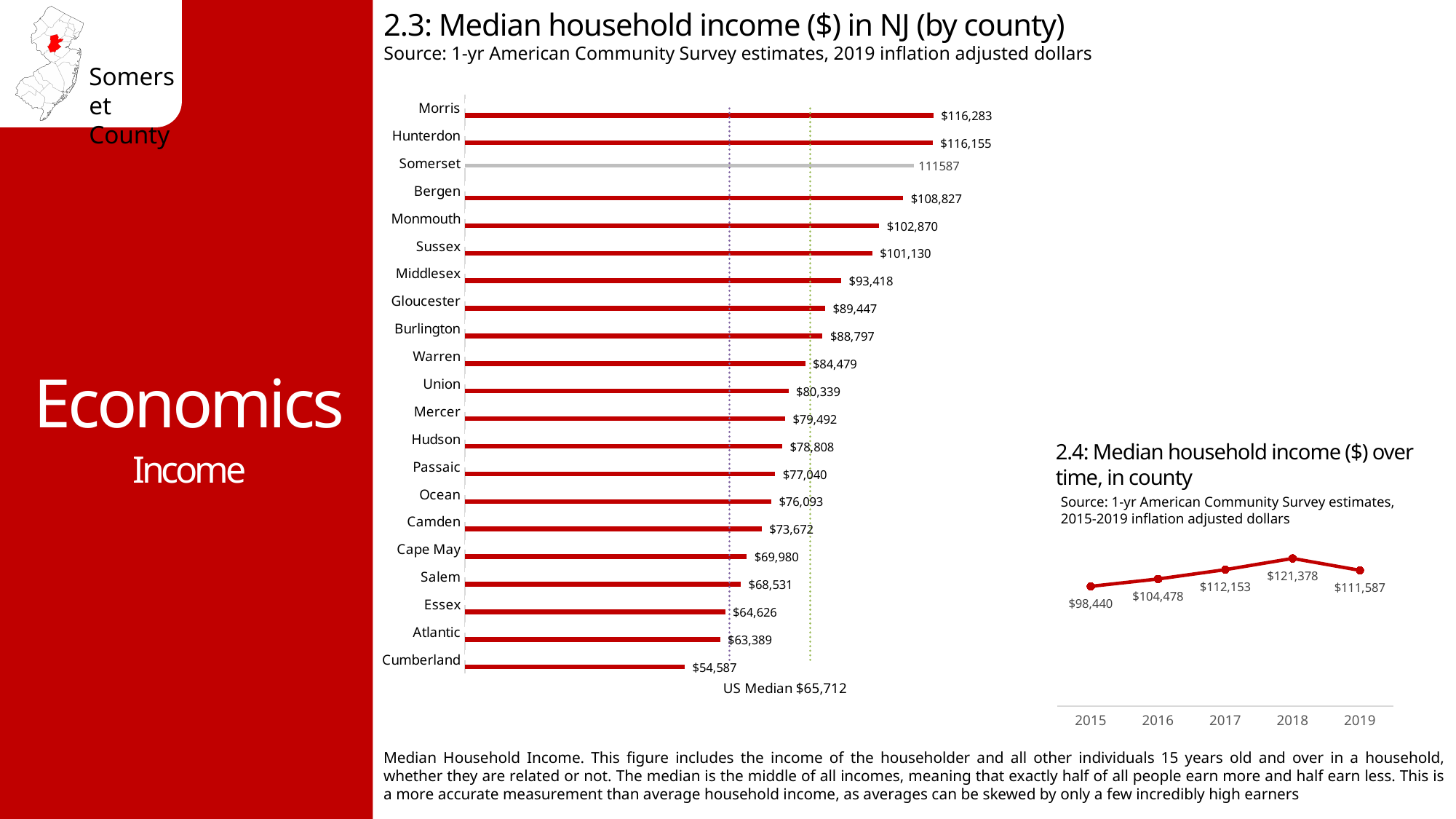
In chart 2.3, what is the difference between the median household income of Middlesex and Gloucester? $3,971 In chart 2.4 (Median household income over time, in county), what is the value for 2017? $112,153 How many counties are shown in chart 2.3? 21 In chart 2.3, what US Median value is noted below the bars? $65,712 In chart 2.4, which year has the highest median household income? 2018 In chart 2.4, what is the difference between the 2018 and 2019 values? $9,791 In chart 2.3, what value is shown for Somerset? 111587 In chart 2.3, which county has the lowest median household income? Cumberland In chart 2.4, how does the median household income change from 2015 to 2019? Rises from 2015 to 2018, then falls in 2019 What type of chart is chart 2.3? Bar chart In chart 2.3, which county has a higher median household income, Monmouth or Sussex? Monmouth In chart 2.3 (Median household income in NJ by county), what is the median household income for Bergen? $108,827